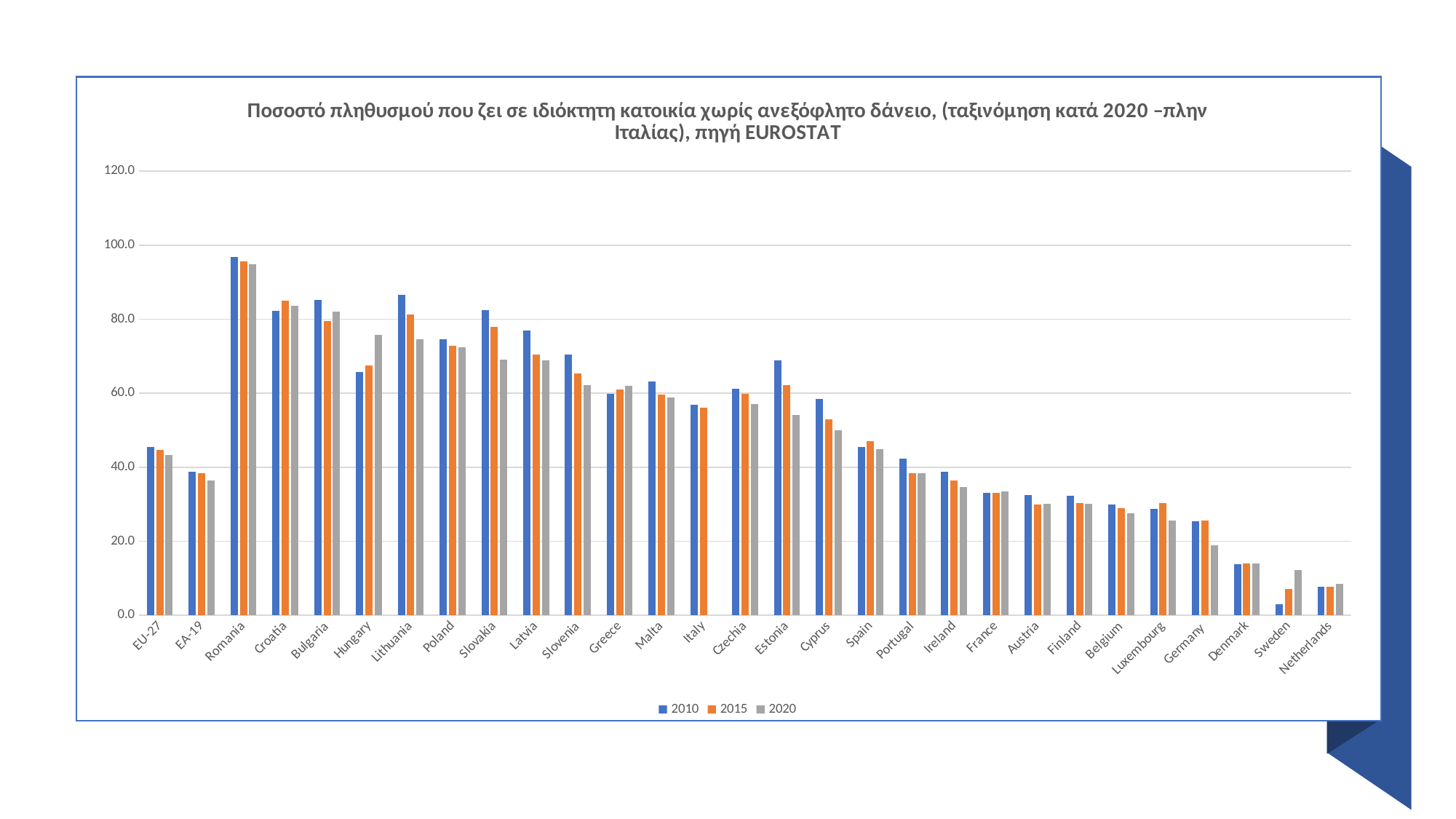
For Hungary, which is larger: the 2010 value or the 2020 value? 2020 How many countries/categories are shown on the x axis? 29 Which category has the highest value for 2020? Romania Is the value for Hungary in 2020 greater or less than 60? greater Which category has the lowest value for 2020? Netherlands Is the value for Netherlands in 2010 greater or less than 20? less How many series does the legend list? 3 Which category has the lowest value for 2010? Sweden For Estonia, which is larger: the 2010 value or the 2020 value? 2010 What kind of chart is shown on the slide? bar chart Which country has no bar for 2020? Italy Is the value for Romania in 2020 greater or less than 80? greater